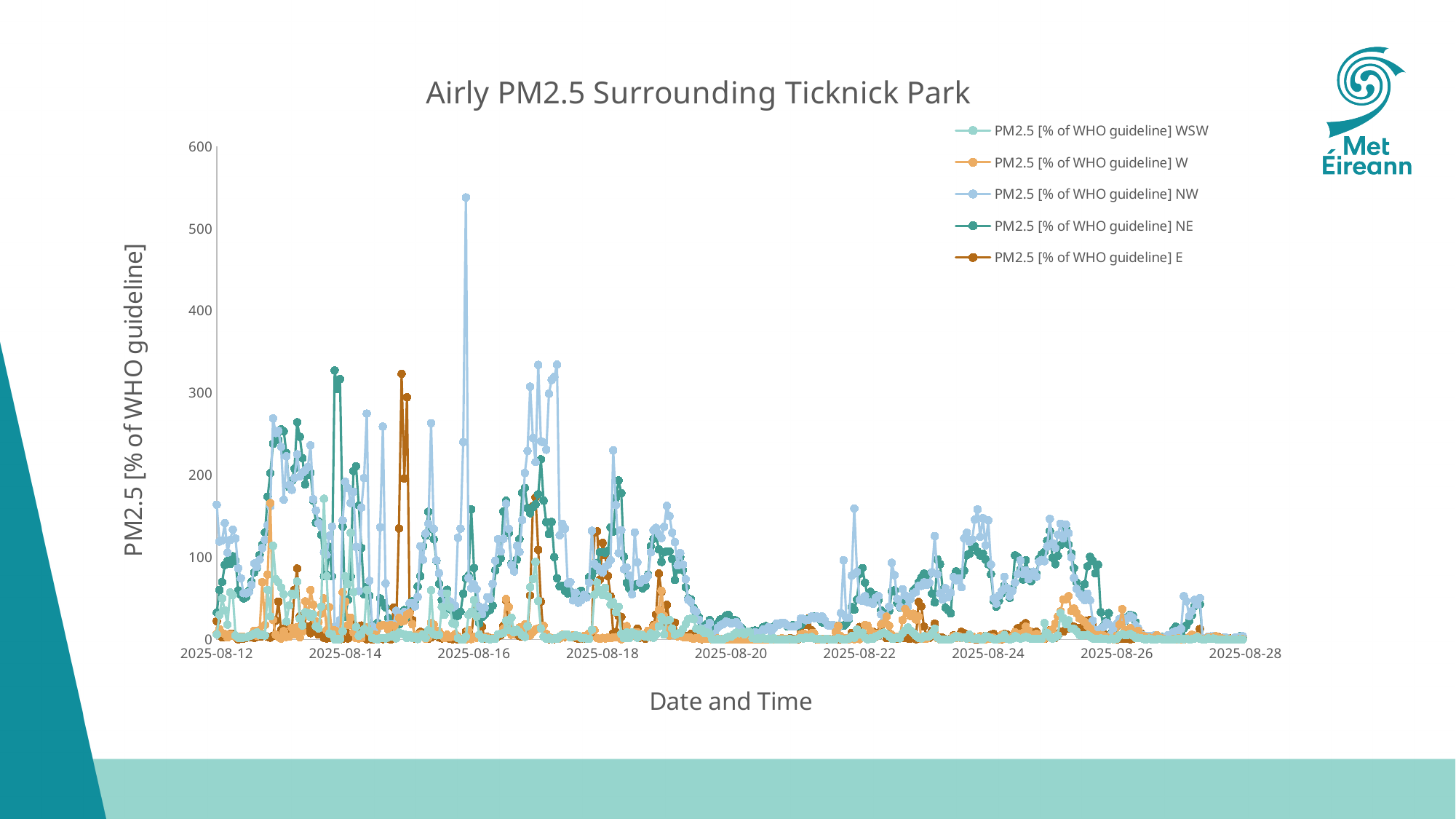
How many series does the legend list? 5 Which series has the higher peak, NW or E? NW What kind of chart is shown on the slide? line chart Is the highest value reached by the NE series greater or less than 300? greater What is the label on the y axis of the chart? PM2.5 [% of WHO guideline] Is the highest value reached by the W series greater or less than 200? less Do the PM2.5 values generally rise or fall from 2025-08-12 to 2025-08-28? fall Is the highest value reached by the E series greater or less than 400? less What is the title of the chart? Airly PM2.5 Surrounding Ticknick Park Which series reaches the highest peak value on the chart? PM2.5 [% of WHO guideline] NW